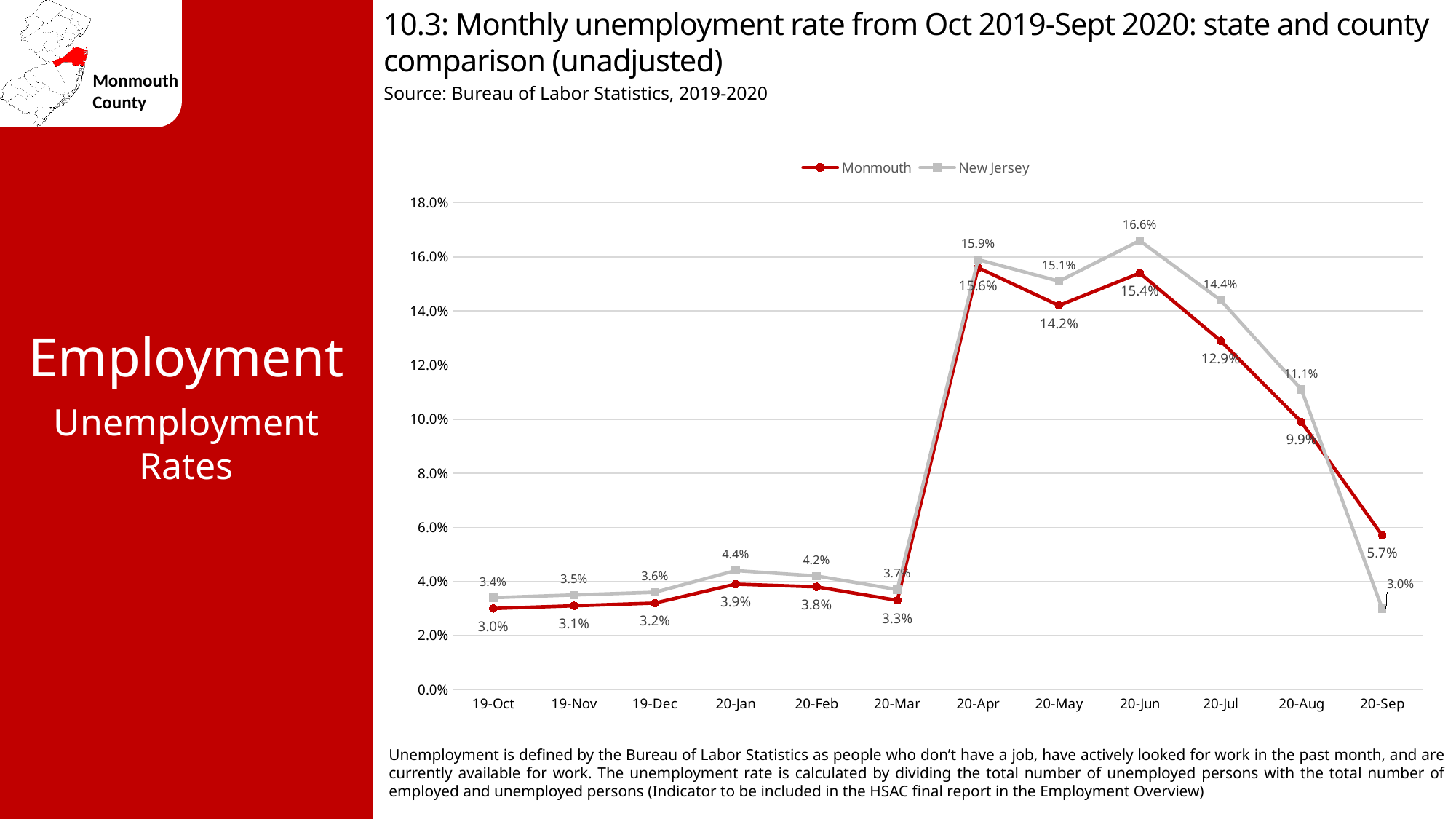
How many series does the legend list? 2 What was the Monmouth unemployment rate in 19-Oct? 3.0% What is the difference between the New Jersey and Monmouth unemployment rates in 20-Aug? 1.2% What was the New Jersey unemployment rate in 20-Jun? 16.6% What kind of chart is shown on the slide? line chart What was the Monmouth unemployment rate in 20-Apr? 15.6% Which had the higher unemployment rate in 20-Sep, Monmouth or New Jersey? Monmouth In which month did the New Jersey unemployment rate reach its highest value? 20-Jun Which colour is used for the Monmouth series? red Is the Monmouth unemployment rate in 20-Jul greater or less than 12.0%? greater How many months are plotted on the x axis? 12 In which month was the Monmouth unemployment rate lowest? 19-Oct